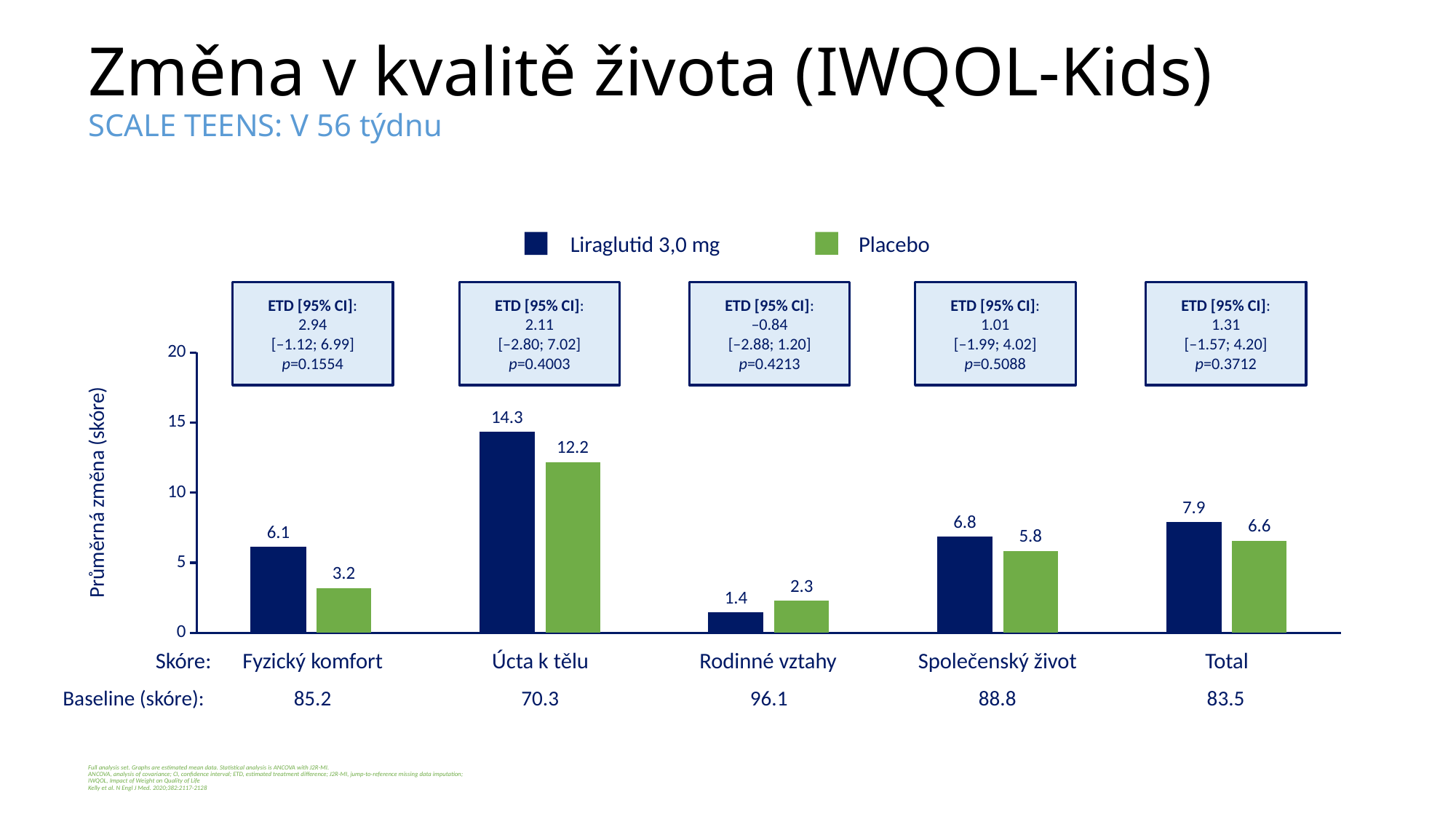
What kind of chart is shown on the slide? bar chart In the Rodinné vztahy category, which series has the larger mean change, Liraglutid 3,0 mg or Placebo? Placebo Which category has the highest mean change for Liraglutid 3,0 mg? Úcta k tělu Which category has the lowest mean change for Placebo? Rodinné vztahy What is the baseline score for Rodinné vztahy? 96.1 How many score categories are shown on the x axis? 5 What is the mean change for Liraglutid 3,0 mg in the Úcta k tělu category? 14.3 Is the Liraglutid 3,0 mg value for Úcta k tělu greater or less than 10? greater How many series does the legend list? 2 What is the Total mean change for Placebo? 6.6 What is the mean change for Placebo in the Fyzický komfort category? 3.2 What is the difference between the Liraglutid 3,0 mg and Placebo values for Společenský život? 1.0